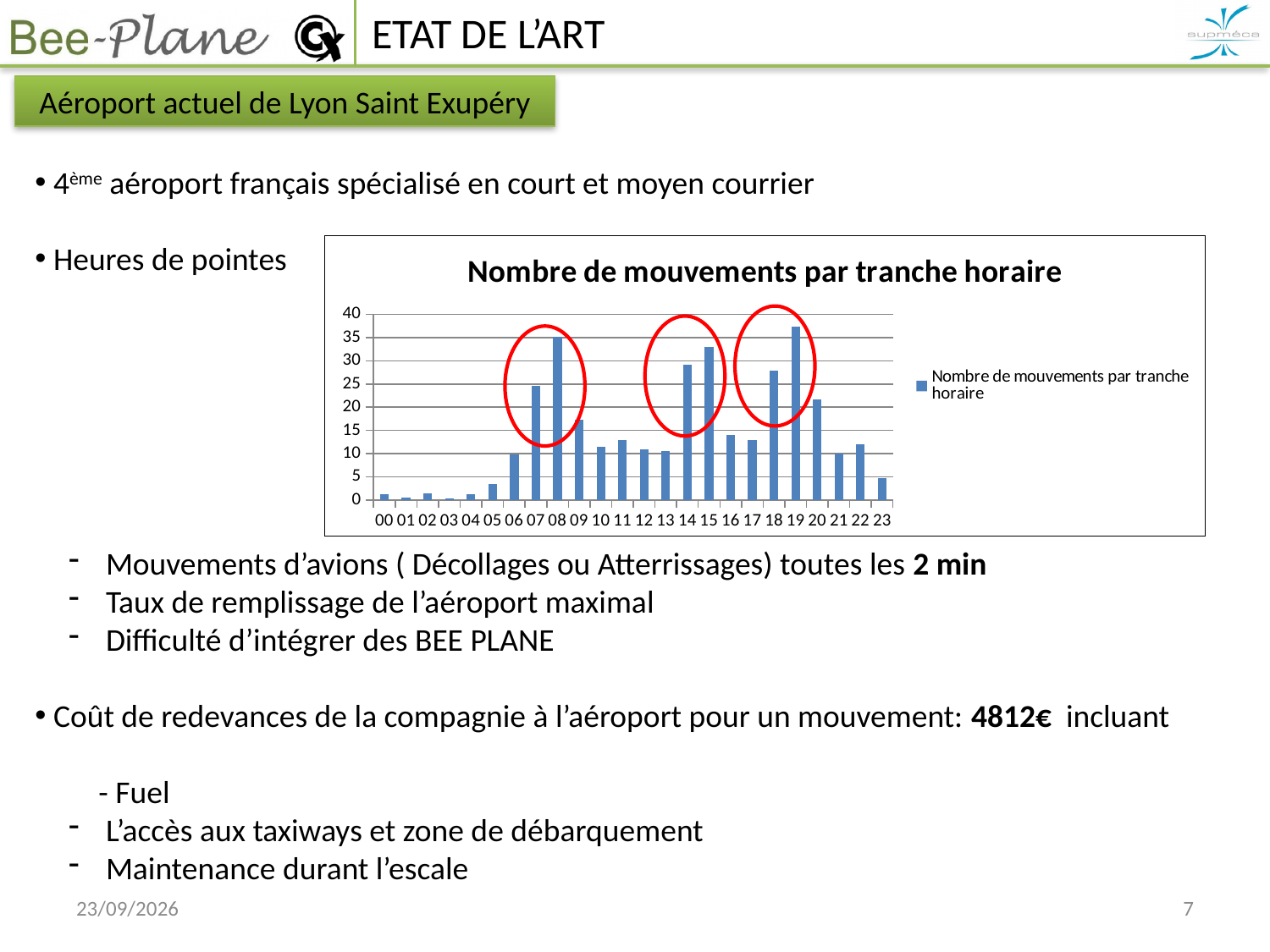
Which hour has more movements, 15 or 14? 15 Is the value for hour 08 greater or less than 30? greater Is the value for hour 23 greater or less than 10? less Is the value for hour 15 greater or less than 30? greater Which hour has the highest number of movements in the chart? 19 Which hour has more movements, 20 or 22? 20 How many series does the chart legend list? 1 How many hourly categories are shown on the x axis of the chart? 24 What is the title of the chart? Nombre de mouvements par tranche horaire What kind of chart is shown on the slide? bar chart